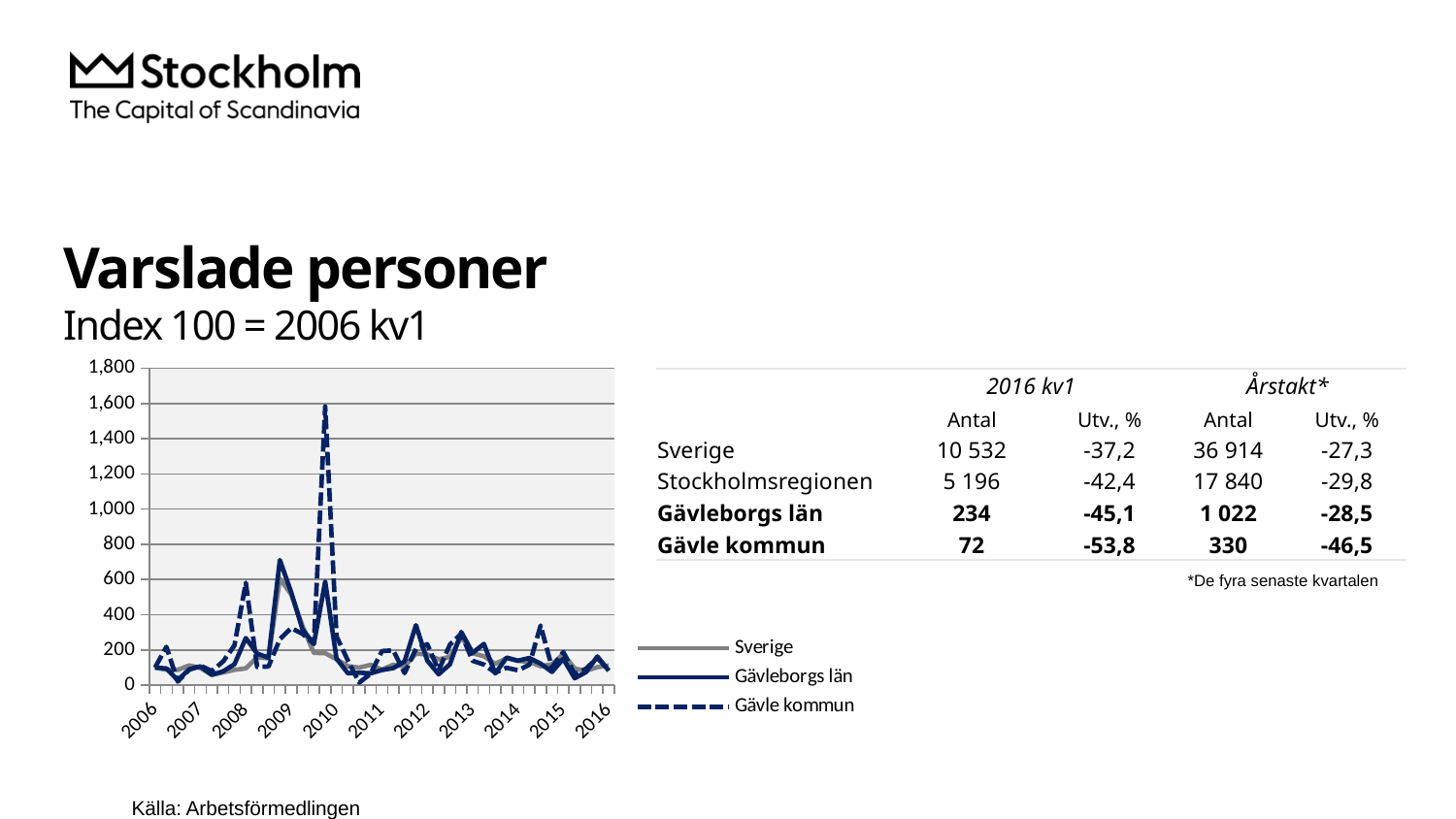
Which series reaches the highest value anywhere in the chart? Gävle kommun Which series in the chart is drawn with a dashed line? Gävle kommun Is the value for Sverige at 2016 greater or less than 400? less Do the values for Gävle kommun rise or fall from the 2010 peak to 2016? fall Is the peak value for Gävleborgs län around 2009 greater or less than 600? greater How many series does the chart's legend list? 3 Is the peak value for Gävle kommun around 2008 greater or less than 400? greater How many year labels are shown on the x axis of the chart? 11 What kind of chart is shown on the slide? line chart At the 2010 peak, which series is higher: Gävle kommun or Sverige? Gävle kommun Which series are listed in the chart's legend? Sverige, Gävleborgs län, Gävle kommun